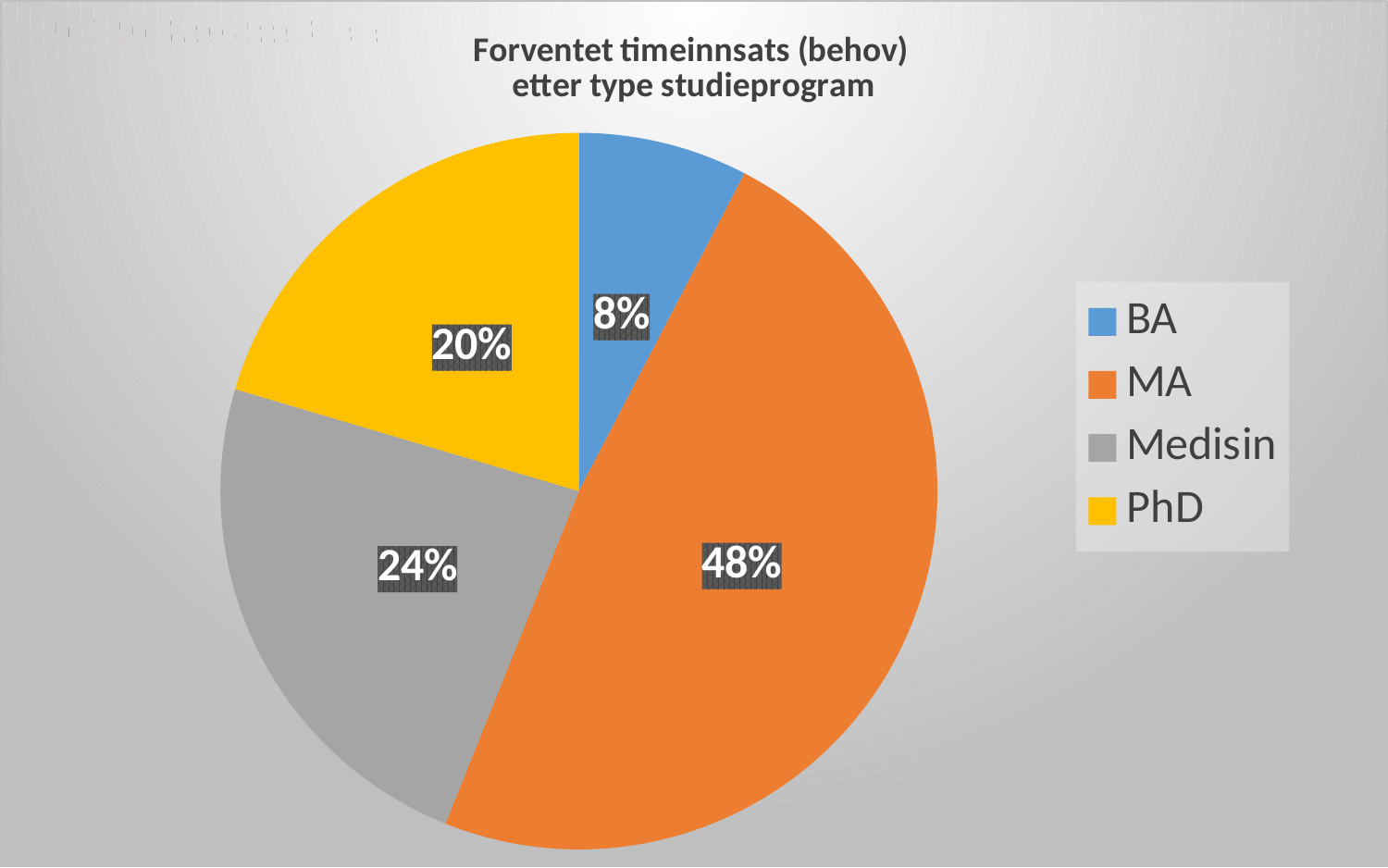
Which is larger, the share for Medisin or the share for PhD? Medisin What percentage share does BA have? 8% What is the title of the chart? Forventet timeinnsats (behov) etter type studieprogram Which category has the largest share of the pie? MA Which category has the smallest share of the pie? BA What percentage share does PhD have? 20% What type of chart is shown on the slide? pie chart What percentage share does Medisin have? 24% How many categories does the legend list? 4 What is the difference in percentage points between MA and Medisin? 24 What percentage share does MA have? 48% What colour represents PhD in the chart? yellow